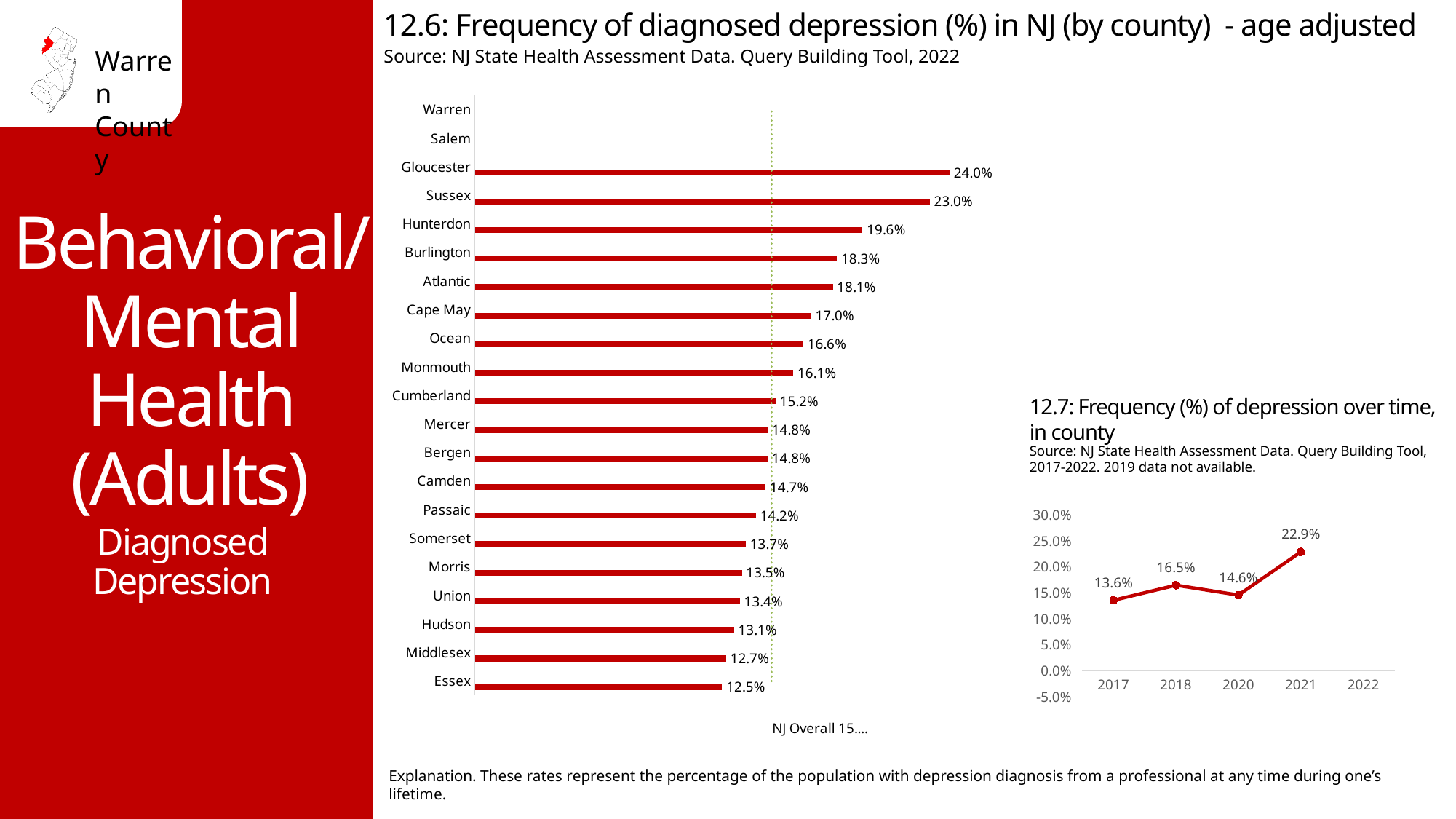
In chart 12.6, what is the value for Middlesex? 12.7% In chart 12.6, what is the value for Hunterdon? 19.6% In chart 12.6, which county has the highest frequency of diagnosed depression among those with bars shown? Gloucester In chart 12.7, what kind of chart is used? Line chart In chart 12.6, which county has the lowest frequency of diagnosed depression among those with bars shown? Essex In chart 12.6, which county has a higher value, Burlington or Atlantic? Burlington In chart 12.6, what is the frequency of diagnosed depression for Gloucester? 24.0% In chart 12.7, which year has the lowest frequency of depression? 2017 In chart 12.6, what kind of chart is used? Bar chart In chart 12.6, what is the difference between the values for Gloucester and Sussex? 1.0% In chart 12.7, what is the difference between the 2021 and 2020 values? 8.3% In chart 12.7, what is the frequency of depression in 2021? 22.9%